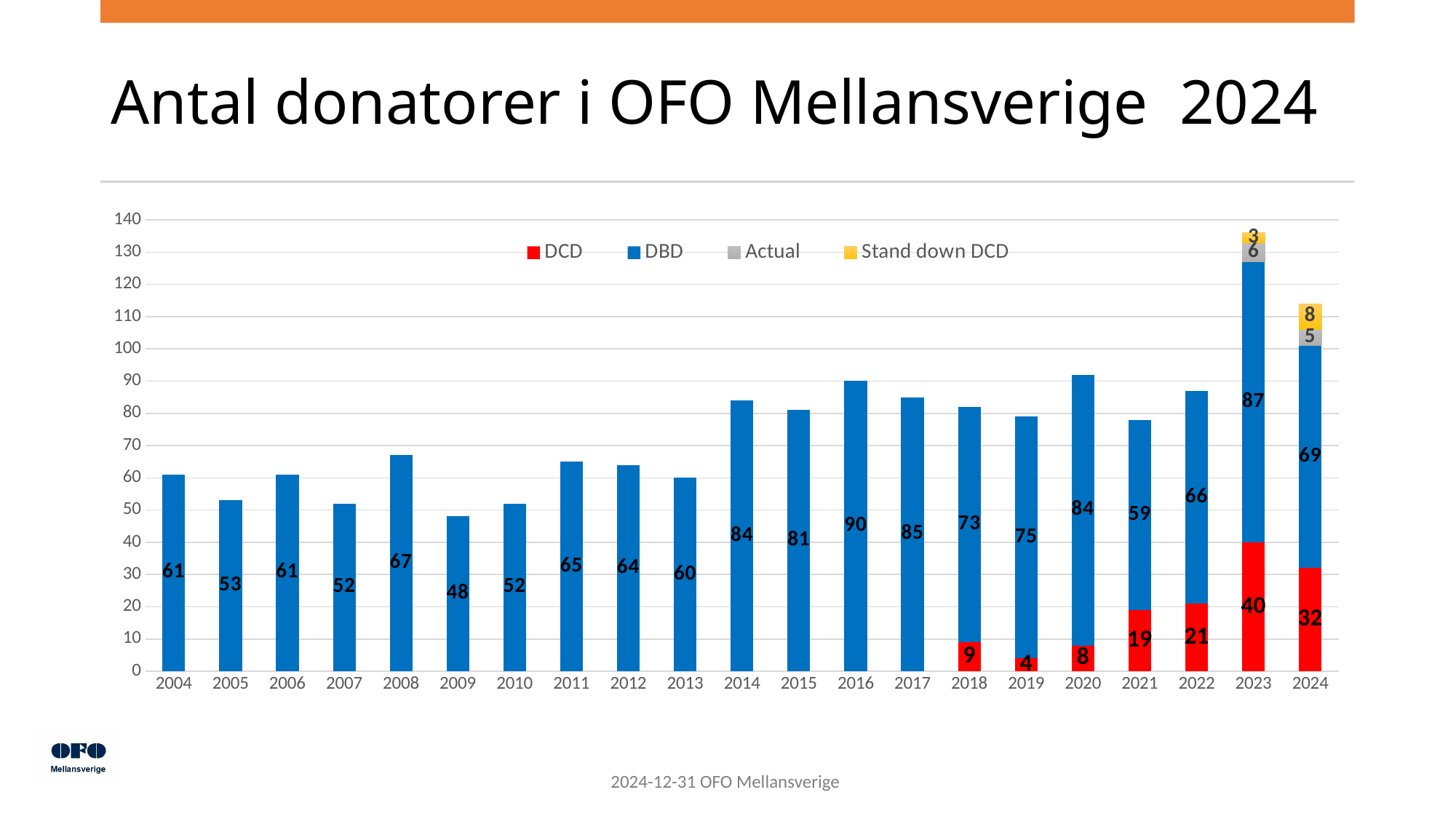
What is the total of the stacked bar for 2024? 114 What is the DCD value for 2023? 40 What is the DBD value for 2016? 90 What is the difference between the DCD values for 2023 and 2024? 8 What type of chart is shown on the slide? Stacked bar chart Which series is shown in red in the legend? DCD How many series does the legend list? 4 What is the Stand down DCD value for 2024? 8 Which year has the highest DCD value? 2023 Which is larger, the DBD value for 2014 or the DBD value for 2015? 2014 How many years are shown on the x axis? 21 Which year has the lowest DBD value? 2009